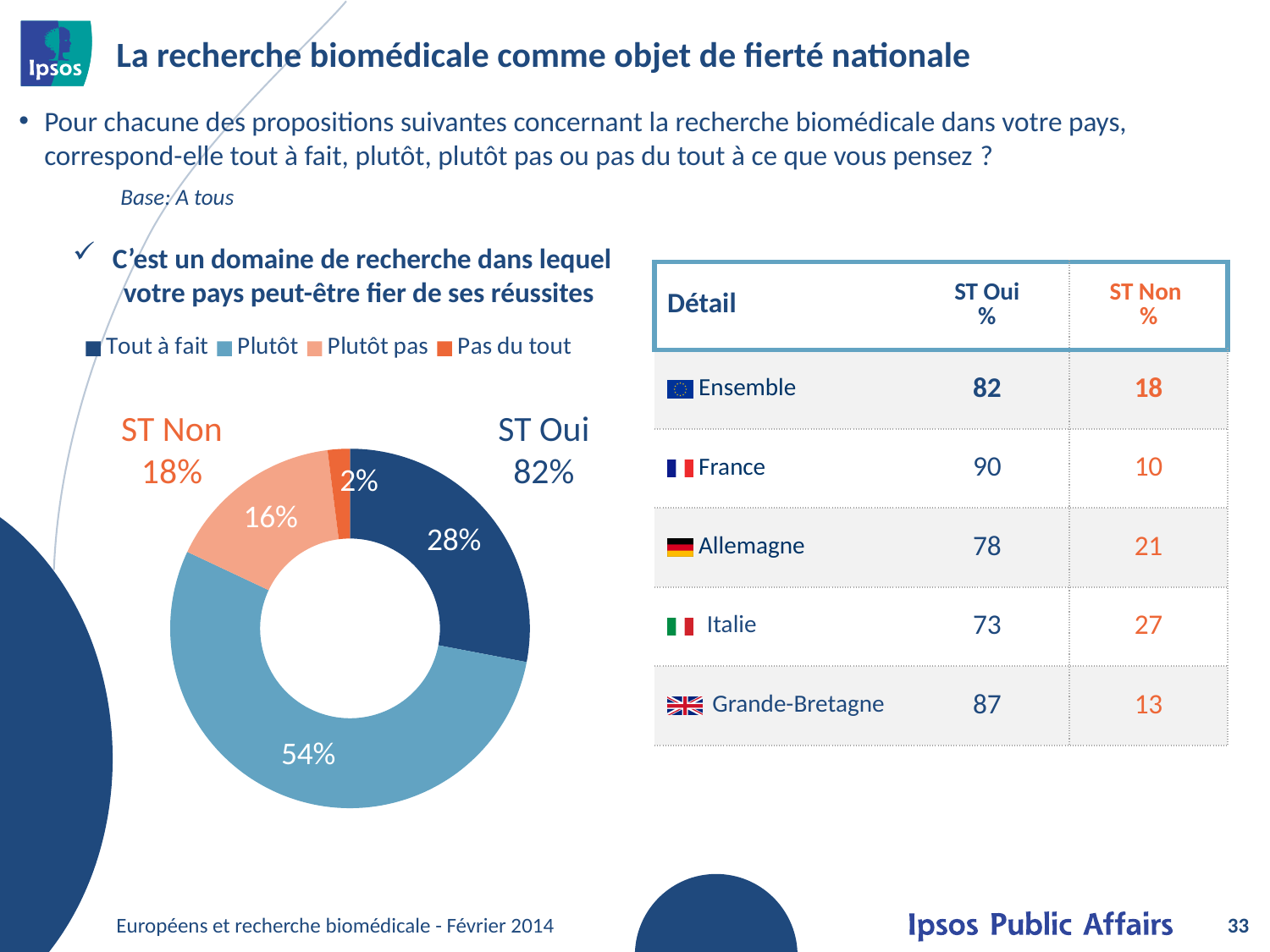
Which is larger in the donut chart, "Plutôt pas" or "Tout à fait"? Tout à fait Which category has the smallest slice in the donut chart? Pas du tout What is the value for "Tout à fait" in the donut chart? 28% What is the ST Non share shown next to the donut chart? 18% What is the value for "Pas du tout" in the donut chart? 2% What is the value for "Plutôt" in the donut chart? 54% How many categories does the legend of the donut chart list? 4 What is the value for "Plutôt pas" in the donut chart? 16% Which category has the largest slice in the donut chart? Plutôt What is the combined share of "Tout à fait" and "Plutôt" (ST Oui) shown next to the donut chart? 82% What is the difference between the "Plutôt" and "Tout à fait" slices? 26 percentage points What kind of chart is shown on the slide? Donut (pie) chart